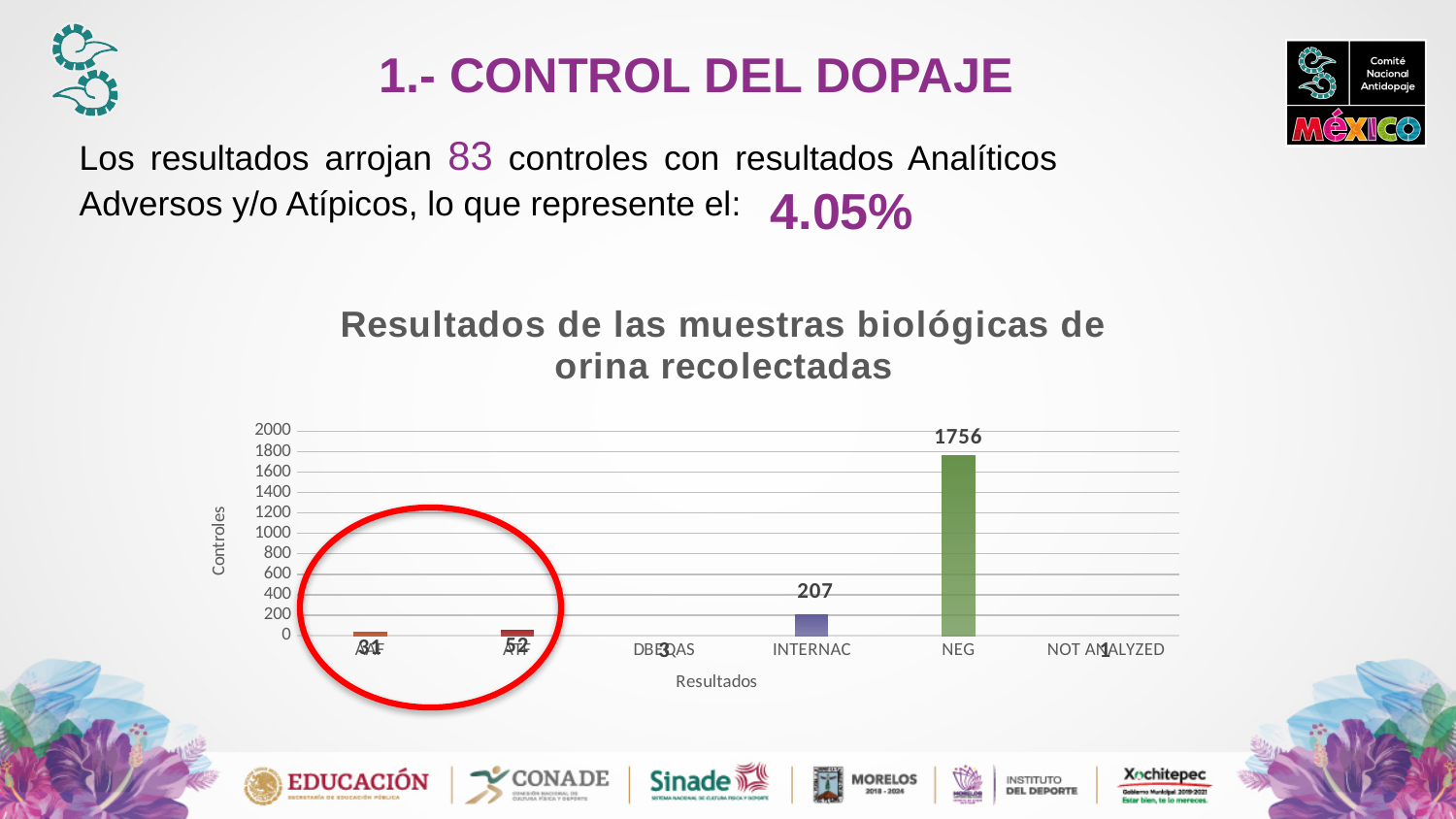
What is the title of the chart? Resultados de las muestras biológicas de orina recolectadas What is the label of the vertical axis? Controles Is the value for NEG greater or less than 1600? greater Is the value for INTERNAC greater or less than 400? less What is the value for INTERNAC? 207 Which is larger, the value for NEG or the value for INTERNAC? NEG Which category has the highest value? NEG What type of chart is shown on the slide? Bar chart What is the difference between the values for NEG and INTERNAC? 1549 How many categories are shown on the x axis? 6 What is the value for NEG? 1756